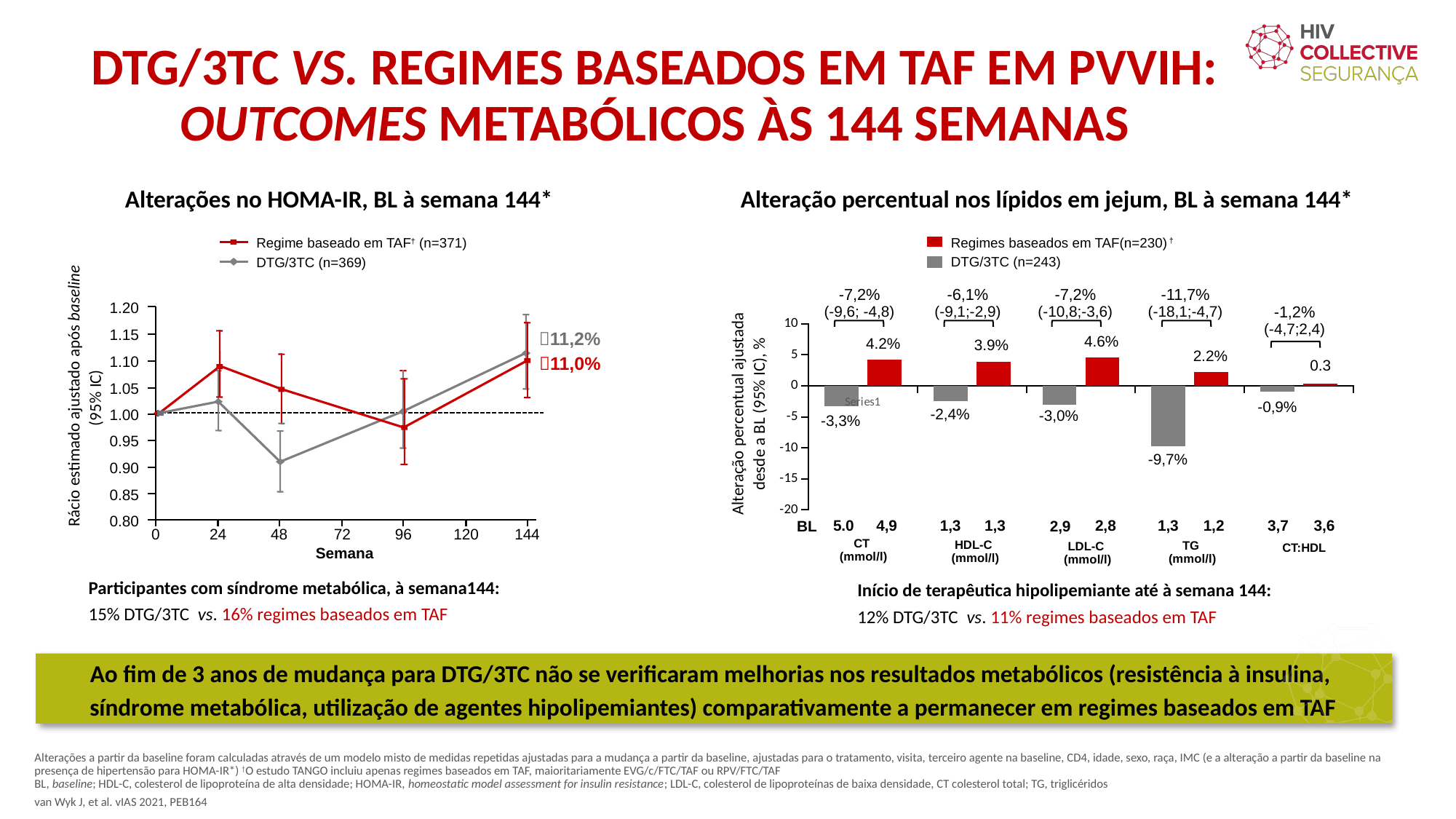
In the right-hand chart (lipids), which lipid parameter has the lowest value for DTG/3TC? TG In the right-hand chart (lipids), what is the adjusted percentage change for DTG/3TC in TG? -9,7% What kind of chart is the right-hand chart, 'Alteração percentual nos lípidos em jejum, BL à semana 144*'? bar chart In the right-hand chart (lipids), which lipid parameter has the highest value for regimes baseados em TAF? LDL-C How many lipid parameters are shown on the x axis of the right-hand chart? 5 In the right-hand chart (lipids), what is the adjusted percentage change for regimes baseados em TAF in LDL-C? 4.6% In the left-hand chart (HOMA-IR), what percentage change is annotated for DTG/3TC at week 144? 11,2% In the left-hand chart (HOMA-IR), at week 48, which series has the higher value: Regime baseado em TAF or DTG/3TC? Regime baseado em TAF In the left-hand chart (HOMA-IR), is the value for DTG/3TC at week 48 greater or less than 0.95? less In the right-hand chart (lipids), what is the adjusted difference printed above the TG bars? -11,7% (-18,1;-4,7) How many series does the legend of the right-hand chart (lipids) list? 2 What kind of chart is the left-hand chart, 'Alterações no HOMA-IR, BL à semana 144*'? line chart